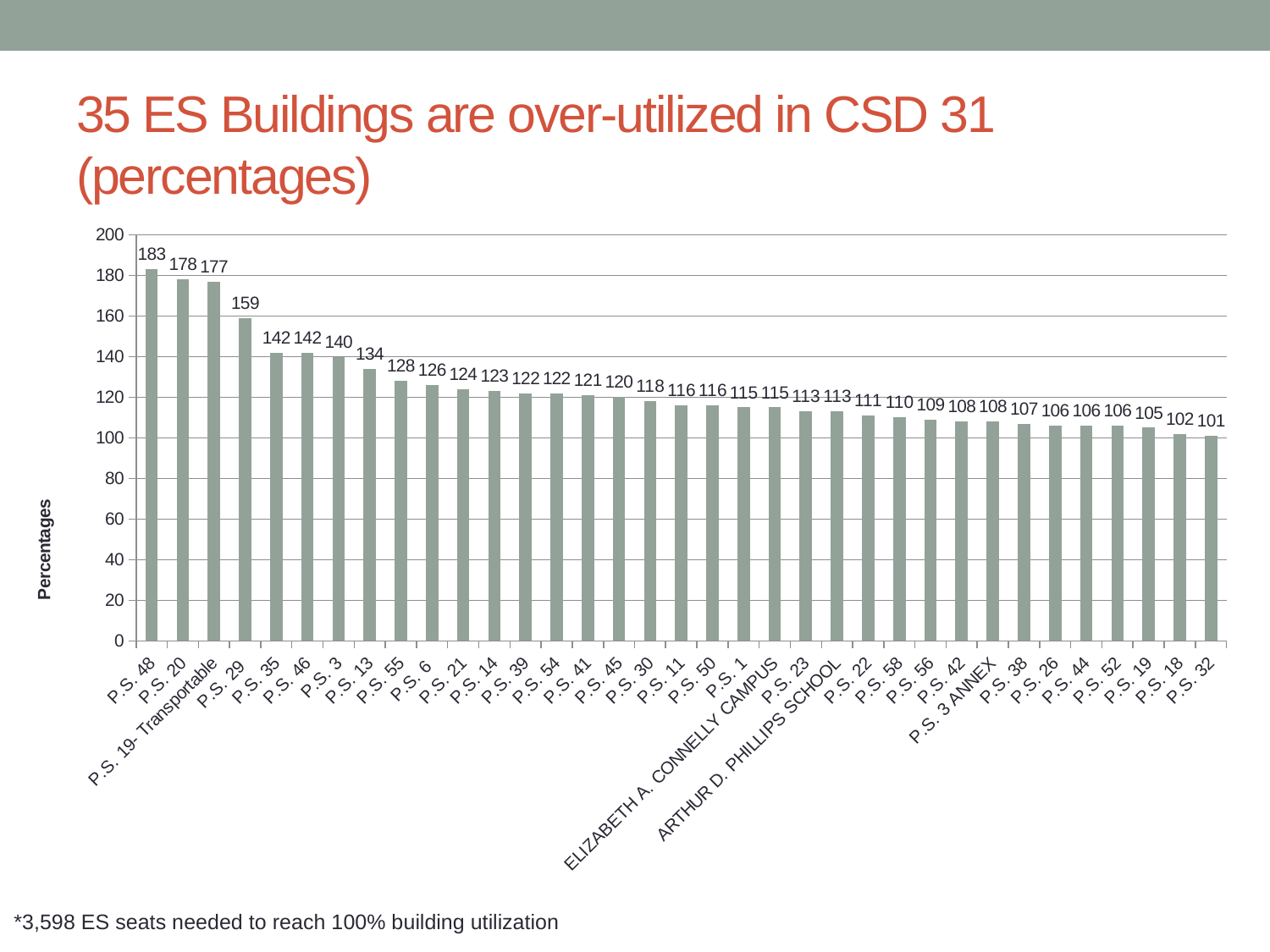
What kind of chart is shown on the slide? Bar chart What is the difference between the values for P.S. 48 and P.S. 20? 5 Which school has the lowest value? P.S. 32 What is the value for P.S. 13? 134 What is the value for P.S. 32? 101 What is the value for P.S. 29? 159 Which is larger, the value for P.S. 55 or the value for P.S. 45? P.S. 55 What is the value for P.S. 48? 183 What is the difference between the values for P.S. 29 and P.S. 32? 58 How many schools are shown on the chart? 35 Do the values rise or fall from left to right along the x axis? Fall Which school has the highest value? P.S. 48